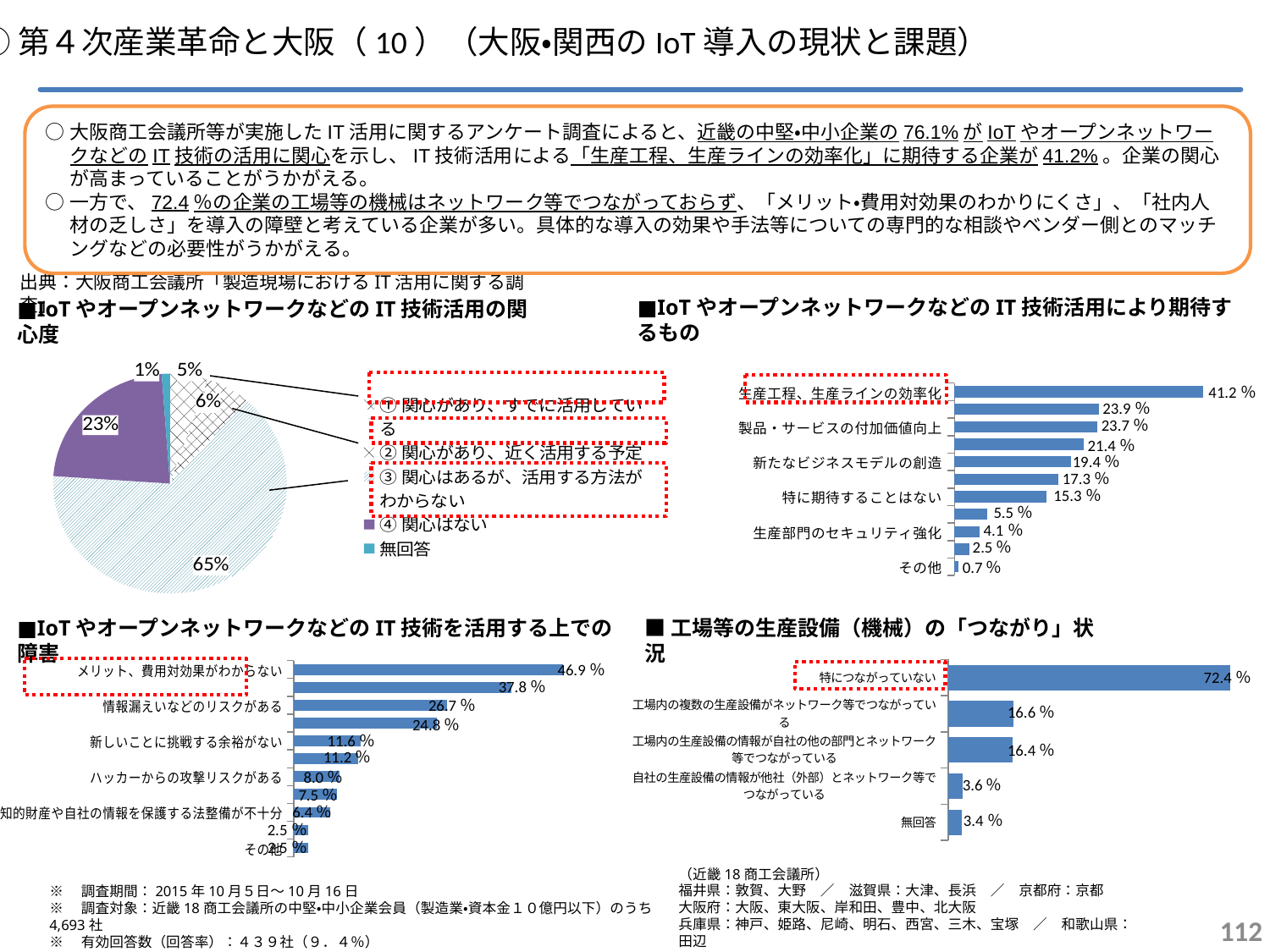
In the pie chart on IT technology interest (関心度), what percentage is shown for 無回答? 1% In the bar chart on what companies expect from IT technology use (期待するもの), what is the value for 生産工程、生産ラインの効率化? 41.2% In the bar chart on obstacles to using IT technology (障害), which is larger: 情報漏えいなどのリスクがある or ハッカーからの攻撃リスクがある? 情報漏えいなどのリスクがある In the bar chart on the connectivity status of factory production equipment (つながり状況), how many categories are plotted? 5 In the bar chart on obstacles to using IT technology (障害), what is the value for メリット、費用対効果がわからない? 46.9% In the pie chart on IT technology interest (関心度), what percentage is shown for ④関心はない? 23% In the bar chart on what companies expect from IT technology use (期待するもの), what is the value for 特に期待することはない? 15.3% In the bar chart on what companies expect from IT technology use (期待するもの), what is the difference between 生産工程、生産ラインの効率化 and 製品・サービスの付加価値向上? 17.5% In the bar chart on the connectivity status of factory production equipment (つながり状況), what is the value for 特につながっていない? 72.4% In the bar chart on what companies expect from IT technology use (期待するもの), how many bars are plotted? 11 In the pie chart on IT technology interest (関心度), what percentage does the largest slice represent? 65%